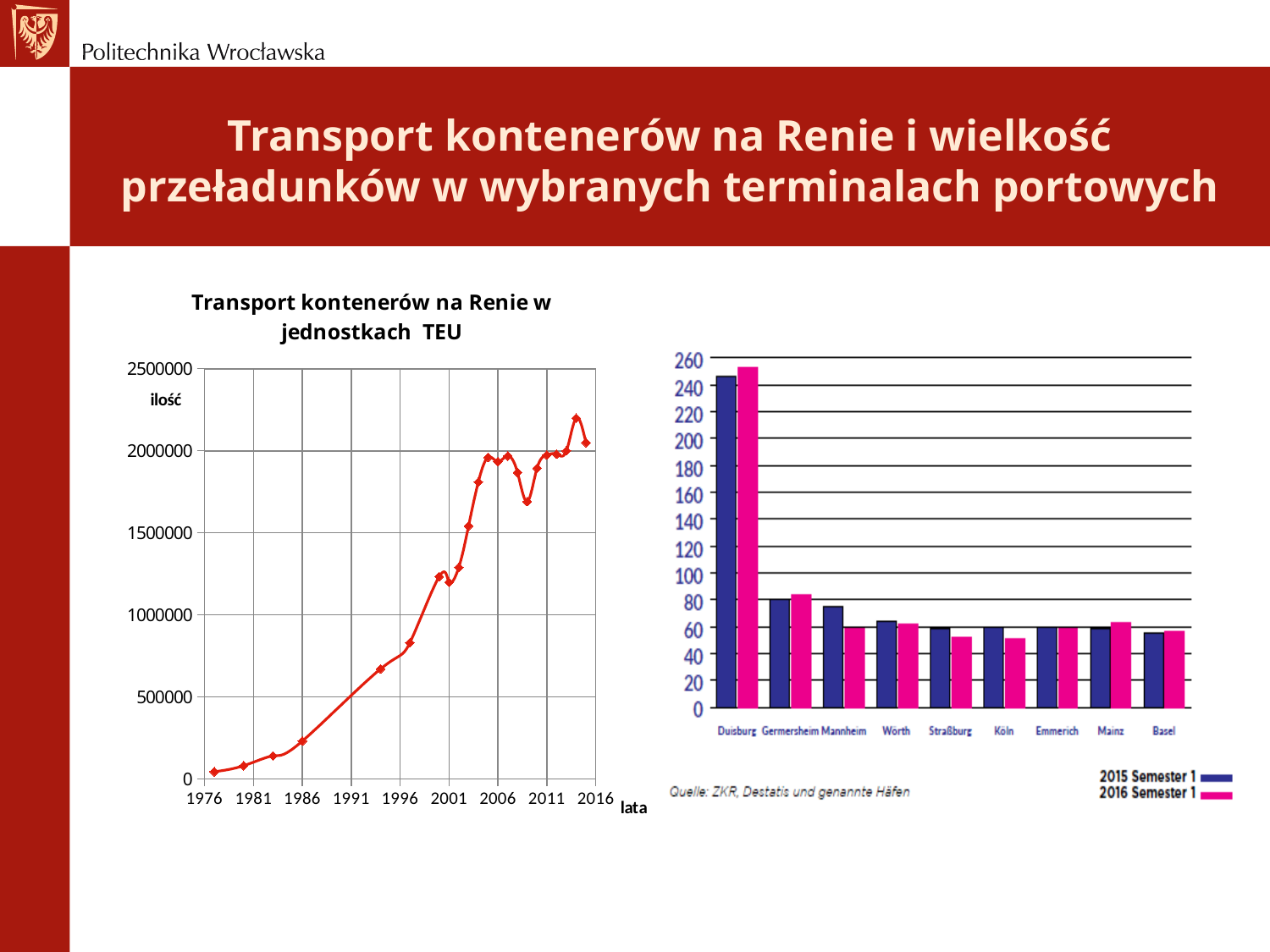
In the left chart 'Transport kontenerów na Renie w jednostkach TEU', is the value for 2006 greater or less than 1500000? greater In the right bar chart, which port has the highest value? Duisburg In the left chart 'Transport kontenerów na Renie w jednostkach TEU', is the value for 1986 greater or less than 500000? less In the right bar chart, is the 2016 Semester 1 value for Köln greater or less than 60? less How many series does the legend of the right bar chart list? 2 In the left chart 'Transport kontenerów na Renie w jednostkach TEU', do the values generally rise or fall from 1976 to 2016? rise How many ports are shown on the x axis of the right bar chart? 9 In the right bar chart, which is larger for Mannheim: 2015 Semester 1 or 2016 Semester 1? 2015 Semester 1 What kind of chart is the left chart titled 'Transport kontenerów na Renie w jednostkach TEU'? line chart What kind of chart is the right chart showing the ports Duisburg to Basel? bar chart